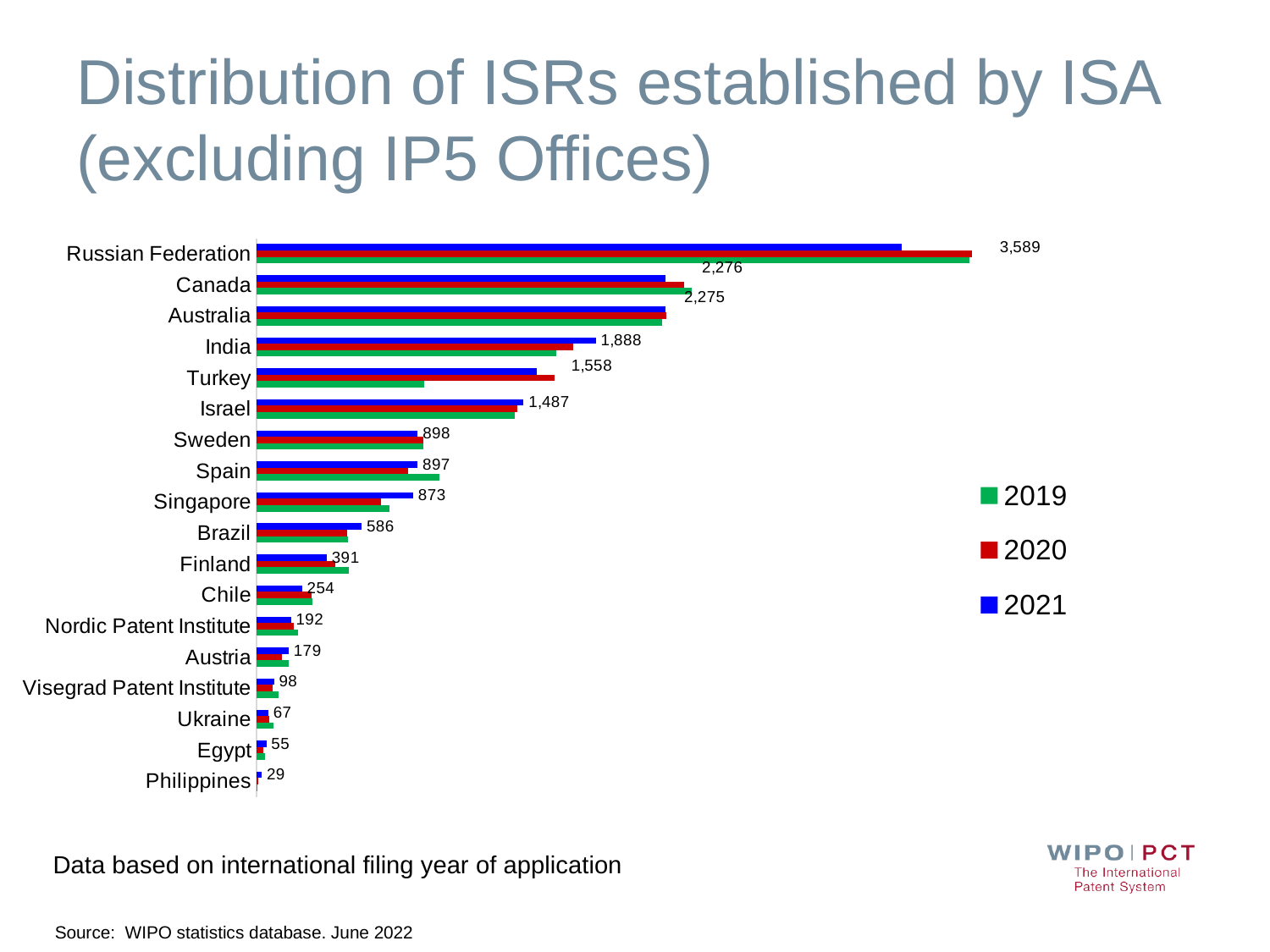
How many ISAs (categories) are shown in the chart? 18 How many series does the legend list? 3 What is the 2021 value for Turkey? 1,558 What is the 2021 value for the Russian Federation? 3,589 What is the 2021 value for the Nordic Patent Institute? 192 What kind of chart is shown on the slide? bar chart What is the difference between the 2021 values for the Russian Federation and Canada? 1,313 For the Russian Federation, which is larger: the 2020 value or the 2021 value? 2020 Which ISA has the lowest 2021 value? Philippines What is the difference between the 2021 values for Brazil and Finland? 195 Which ISA has the highest 2021 value? Russian Federation Which colour represents the 2019 series in the legend? green